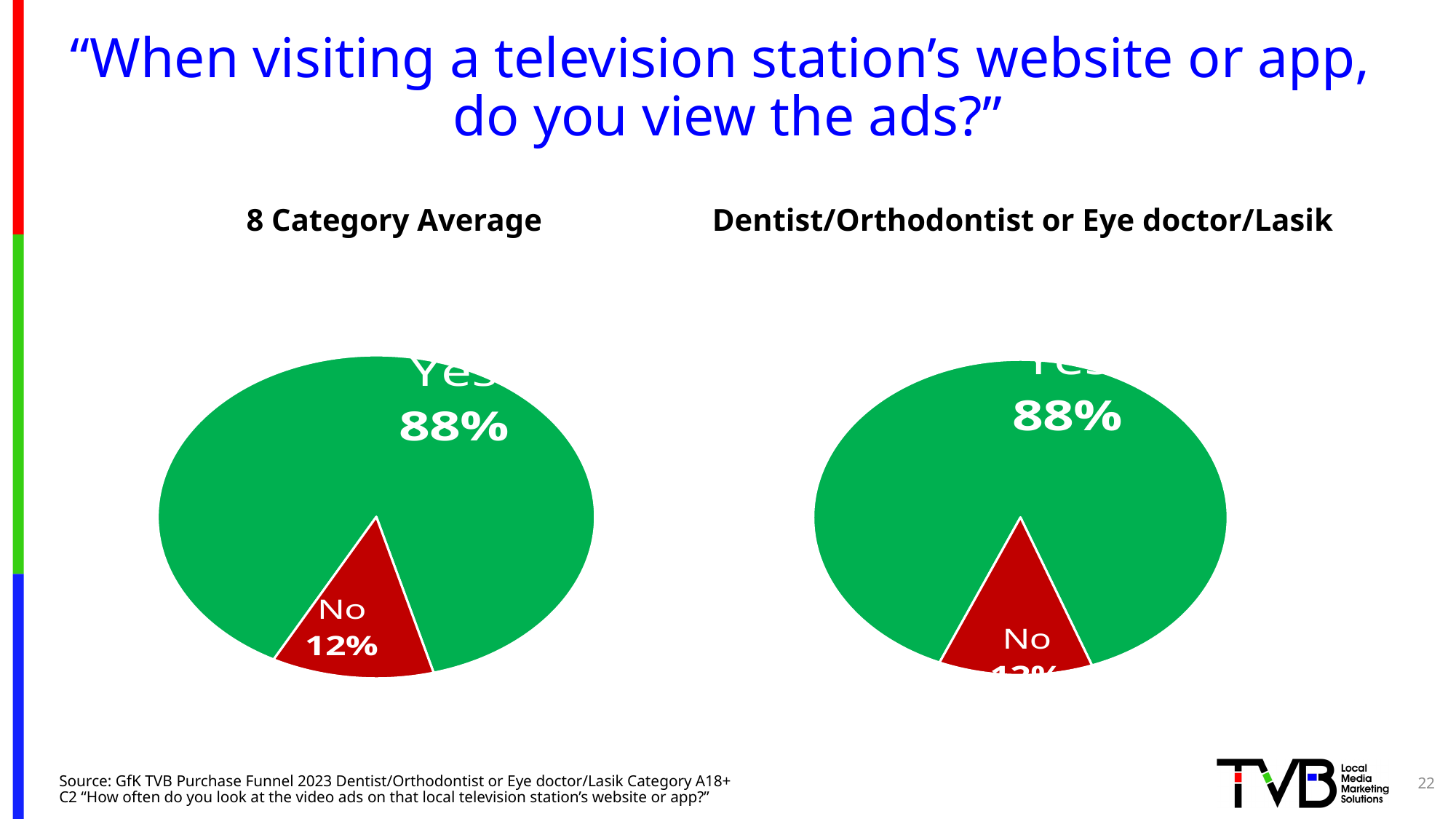
Is the Yes value in the 8 Category Average pie chart greater or less than 50%? greater In the Dentist/Orthodontist or Eye doctor/Lasik pie chart, which is larger, the Yes slice or the No slice? Yes In the 8 Category Average pie chart, what is the difference between the Yes and No percentages? 76% In the Dentist/Orthodontist or Eye doctor/Lasik pie chart, what percentage answered Yes? 88% In the Dentist/Orthodontist or Eye doctor/Lasik pie chart, which slice is the smallest? No In the 8 Category Average pie chart, what percentage answered Yes? 88% What colour is the Yes slice in the Dentist/Orthodontist or Eye doctor/Lasik pie chart? Green In the 8 Category Average pie chart, what percentage answered No? 12% How many pie charts are shown on the slide? 2 How many slices does the 8 Category Average pie chart have? 2 In the 8 Category Average pie chart, which slice is the largest? Yes What type of chart is used for the 8 Category Average? Pie chart